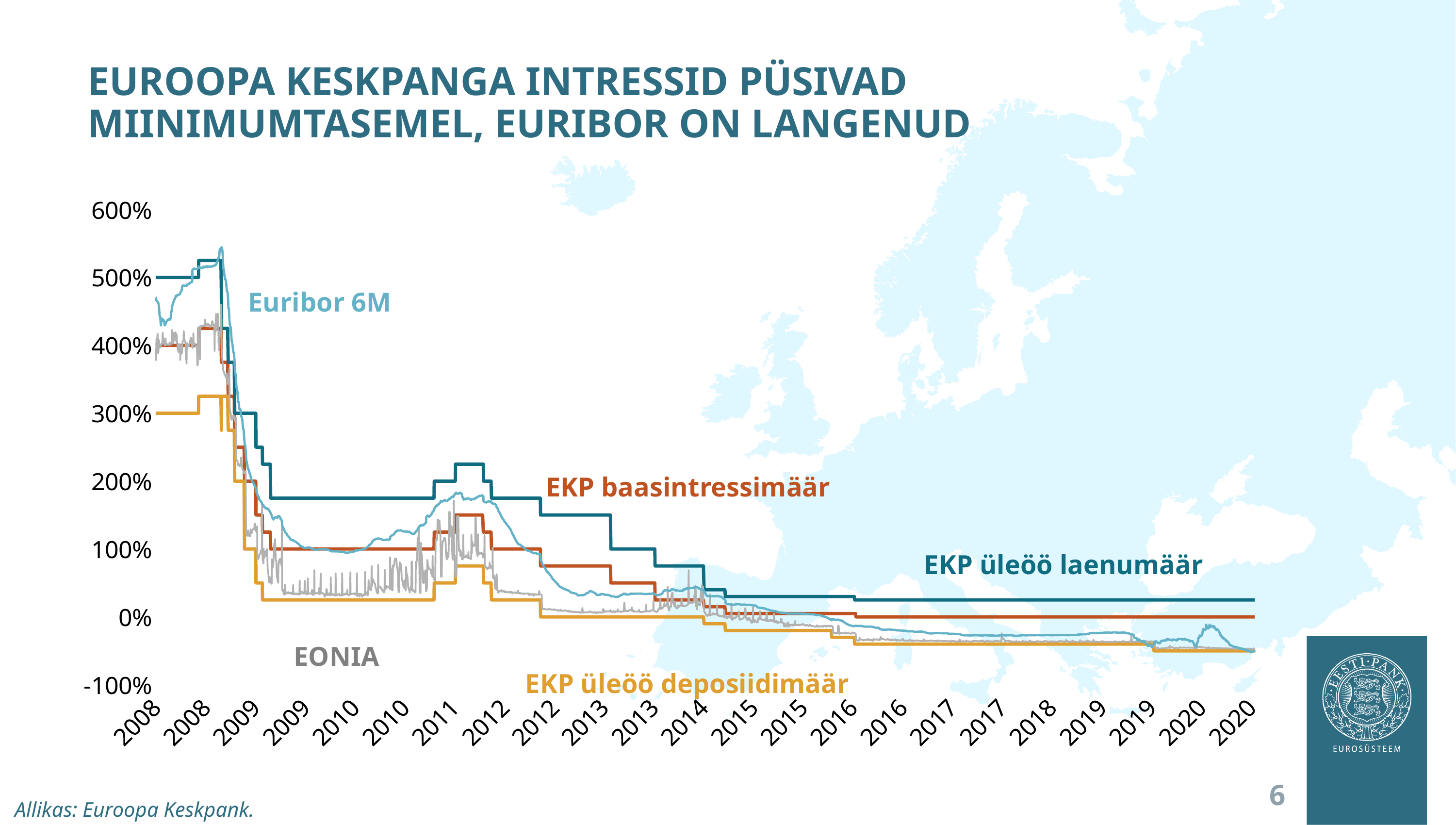
Is the peak value of Euribor 6M in 2008 greater or less than 500%? greater What is the source cited for the chart? Euroopa Keskpank At the end of 2020, is the value for EKP üleöö laenumäär greater or less than 100%? less How many series are labelled on the chart? 5 What kind of chart is shown on the slide? line chart Which series is highest at the end of 2020? EKP üleöö laenumäär Which series is lowest at the start of 2008? EKP üleöö deposiidimäär At the end of 2020, which is higher: EKP baasintressimäär or EKP üleöö deposiidimäär? EKP baasintressimäär Which series is highest at the start of 2008? EKP üleöö laenumäär At the end of 2020, is the value for EKP üleöö deposiidimäär greater or less than 0%? less Does the Euribor 6M series rise or fall overall from 2008 to 2020? fall